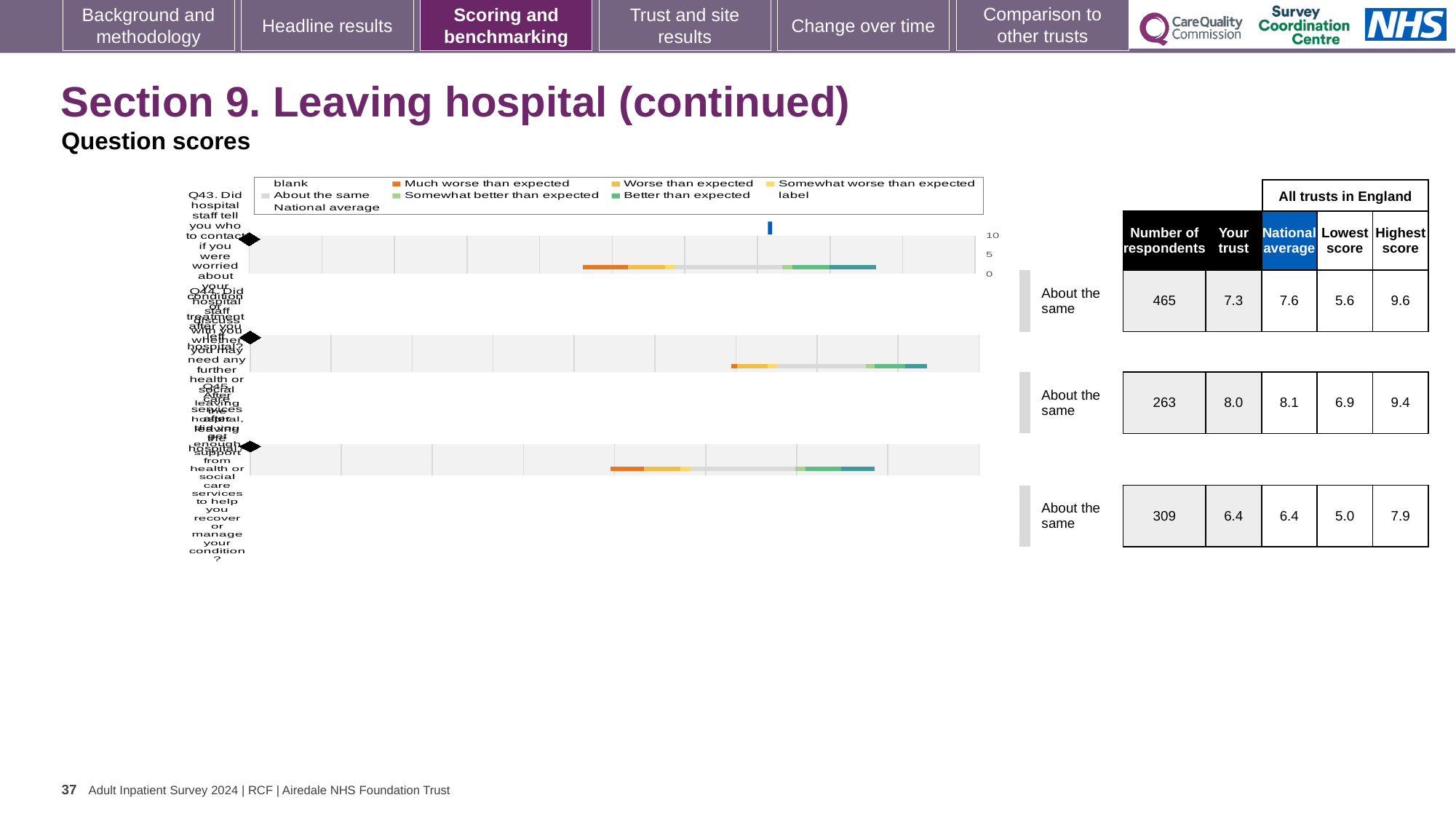
What is the national average score for Q44? 8.1 What kind of chart is shown on the slide? bar chart How many questions are plotted in the chart? 3 Is the trust's score for Q44 higher or lower than the national average? lower What is the 'Your trust' score for Q43? 7.3 Is the trust's score for Q45 greater or less than 5? greater How many respondents answered Q43? 465 What is the lowest score among all trusts in England for Q44? 6.9 What is the highest score among all trusts in England for Q45? 7.9 What is the difference between the national average and the trust's score for Q43? 0.3 Which question has the lowest 'Your trust' score? Q45 Which question has the highest 'Your trust' score? Q44